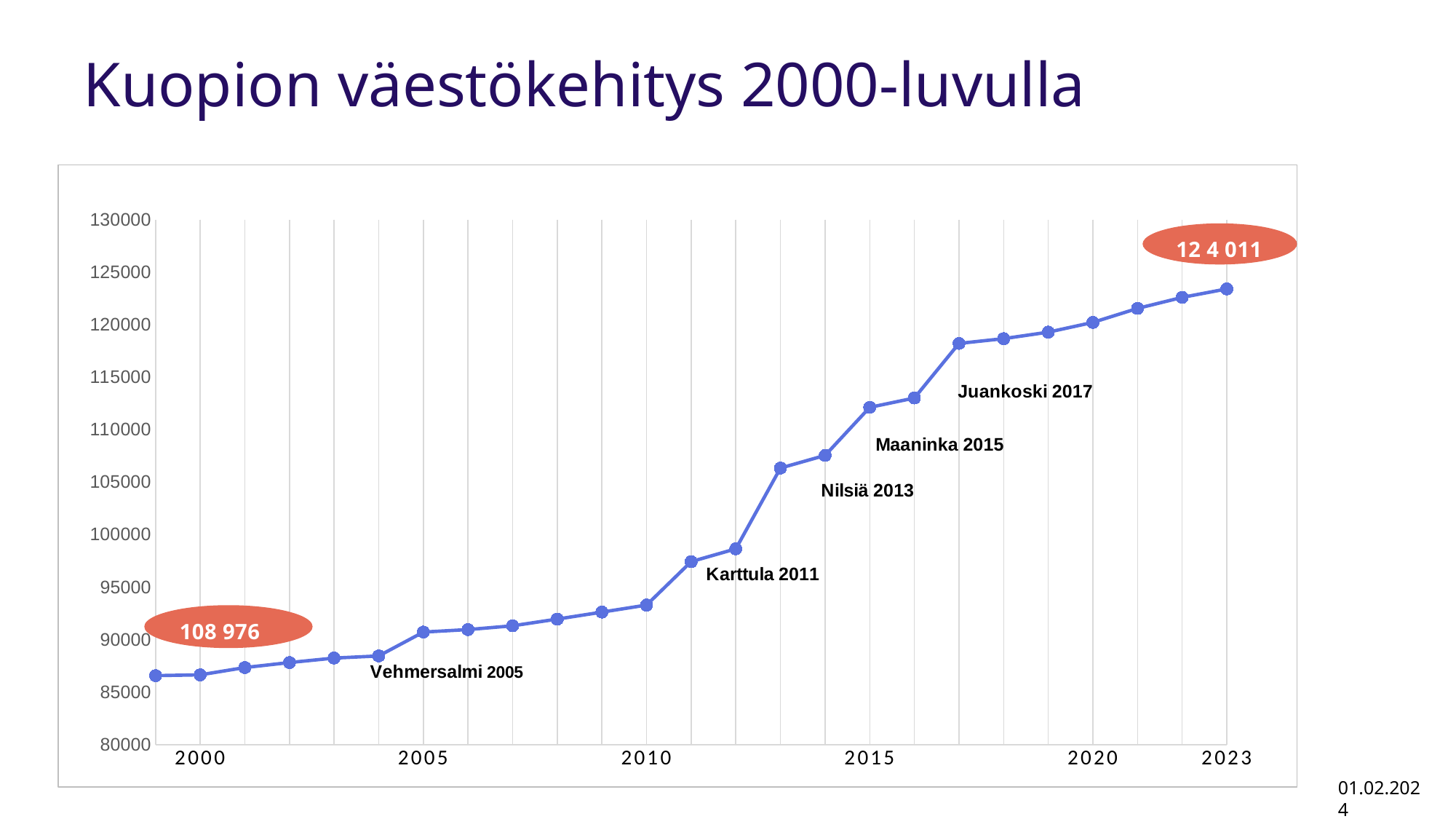
Which municipality merger is annotated at 2011 on the chart? Karttula Which year has the highest value on the chart? 2023 What is the title of the slide? Kuopion väestökehitys 2000-luvulla Is the value for 2010 greater or less than 95000? less Do the values generally rise or fall from 2000 to 2023? rise Is the value for 2000 greater or less than 90000? less Which is larger, the value for 2015 or the value for 2010? 2015 What kind of chart is shown on the slide? line chart Is the value for 2023 greater or less than 120000? greater What is the lowest value shown on the vertical axis? 80000